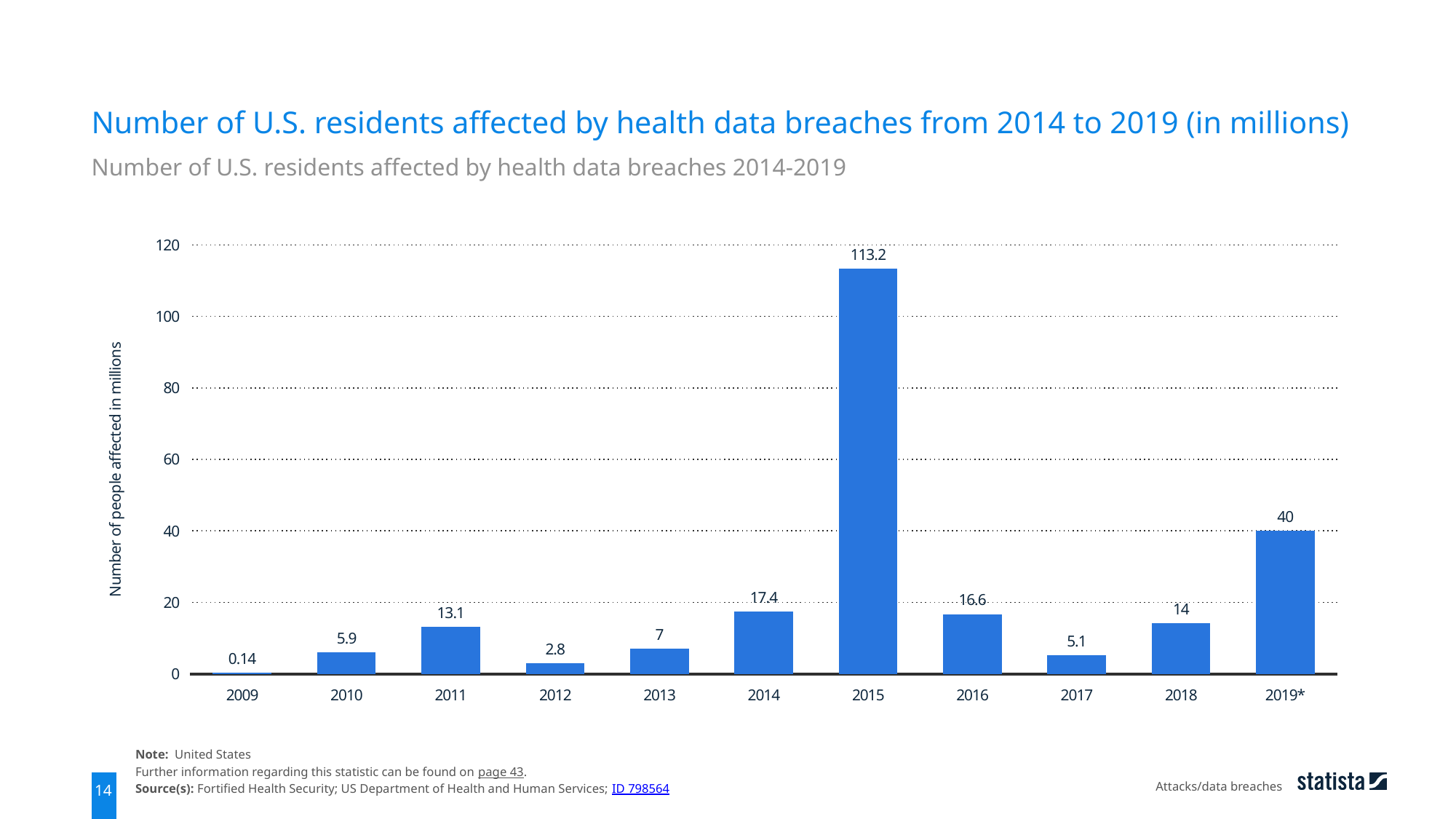
Which year has a larger value, 2011 or 2018? 2018 What is the value for 2009? 0.14 Which year has the highest number of people affected? 2015 What kind of chart is shown on the slide? Bar chart What is the label of the y axis? Number of people affected in millions How many years are shown on the x axis? 11 Do the values rise or fall from 2016 to 2017? Fall Which year has the lowest number of people affected? 2009 What value is shown for 2019*? 40 Is the value for 2015 greater or less than 100? greater What is the number of U.S. residents affected by health data breaches in 2015? 113.2 What is the difference between the values for 2014 and 2016? 0.8